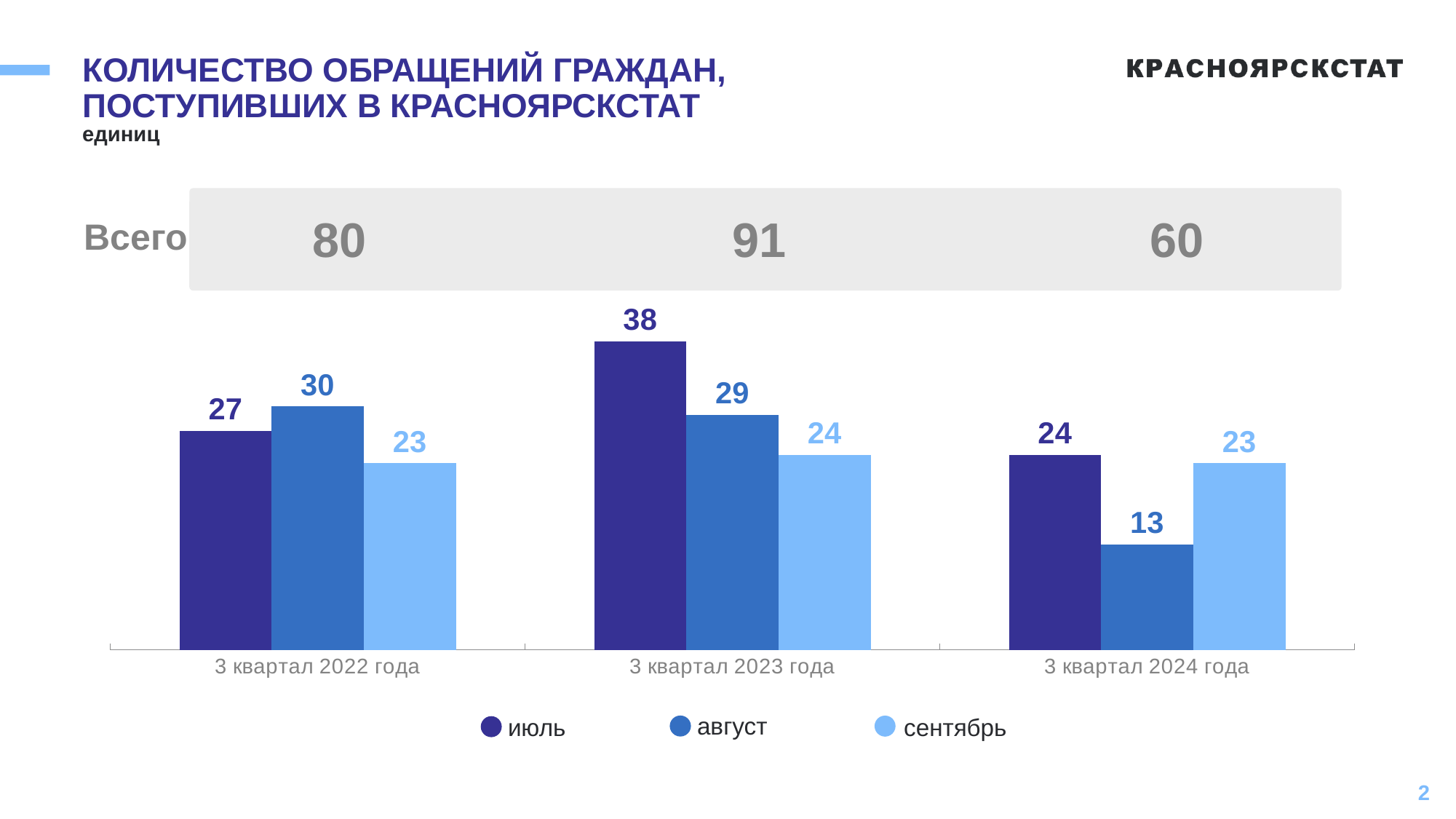
What is the value for сентябрь in 3 квартал 2022 года? 23 Which is larger: the август value in 3 квартал 2022 года or in 3 квартал 2023 года? 3 квартал 2022 года How many series does the legend list? 3 What is the value for июль in 3 квартал 2023 года? 38 What is the total (Всего) shown for 3 квартал 2023 года? 91 Which month has the highest value in 3 квартал 2022 года? август What kind of chart is shown on the slide? bar chart How many quarters are shown on the x axis? 3 Which month has the lowest value in 3 квартал 2024 года? август What unit is stated under the chart title? единиц What is the difference between the июль values for 3 квартал 2023 года and 3 квартал 2024 года? 14 What is the value for август in 3 квартал 2024 года? 13